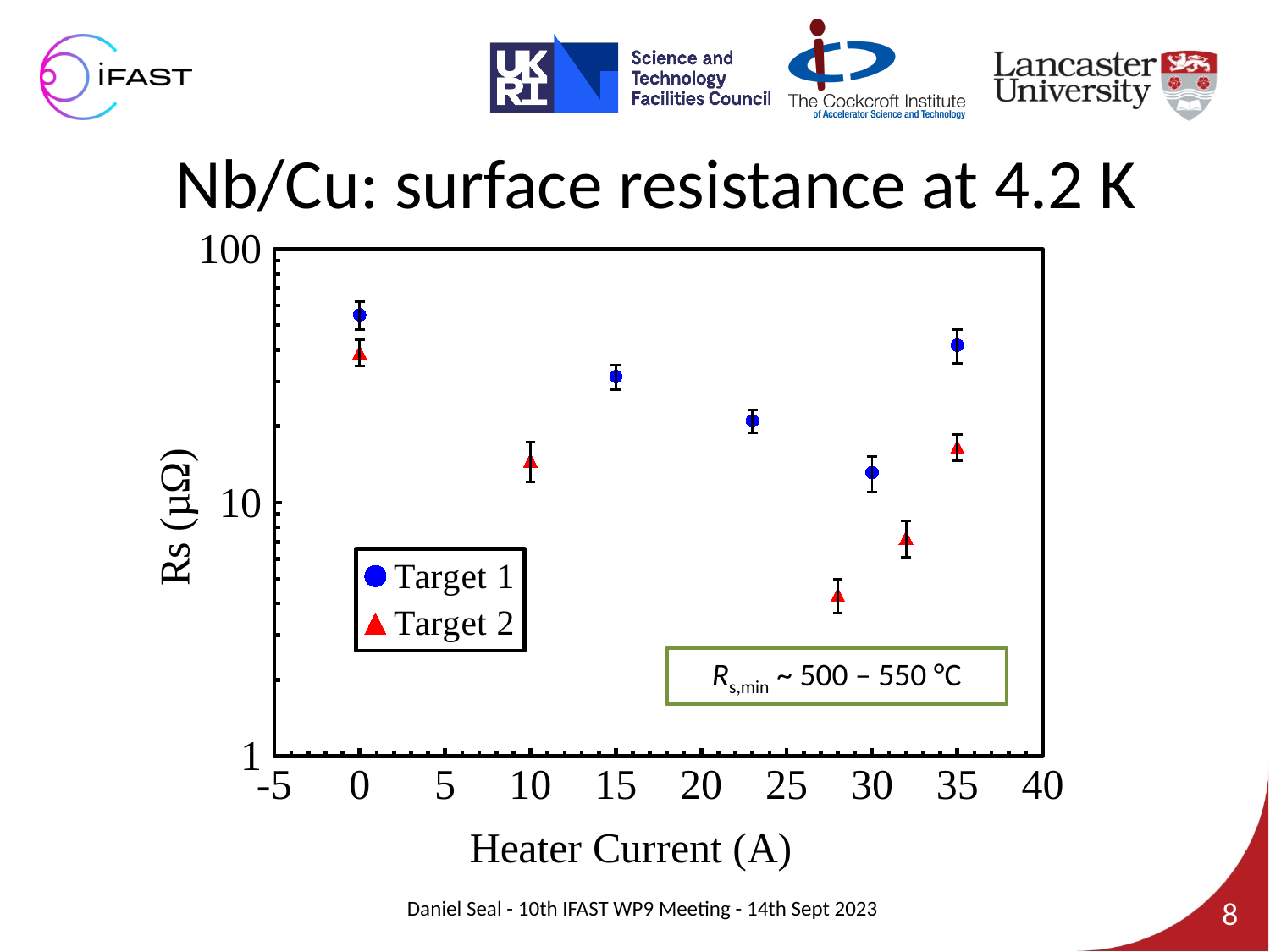
How many data points are plotted for Target 1? 5 What kind of chart is shown on the slide? Scatter plot How many series does the legend list? 2 Is the Rs value for Target 2 at 28 A heater current greater or less than 10 μΩ? less At 35 A heater current, which series has the higher Rs value, Target 1 or Target 2? Target 1 At 0 A heater current, which series has the higher Rs value, Target 1 or Target 2? Target 1 What is the label of the y axis? Rs (μΩ) At which heater current does Target 1 reach its highest Rs value? 0 A Is the Rs value for Target 2 at 10 A heater current greater or less than 10 μΩ? greater At which heater current does Target 2 reach its lowest Rs value? 28 A How many data points are plotted for Target 2? 5 Is the Rs value for Target 1 at 0 A heater current greater or less than 10 μΩ? greater